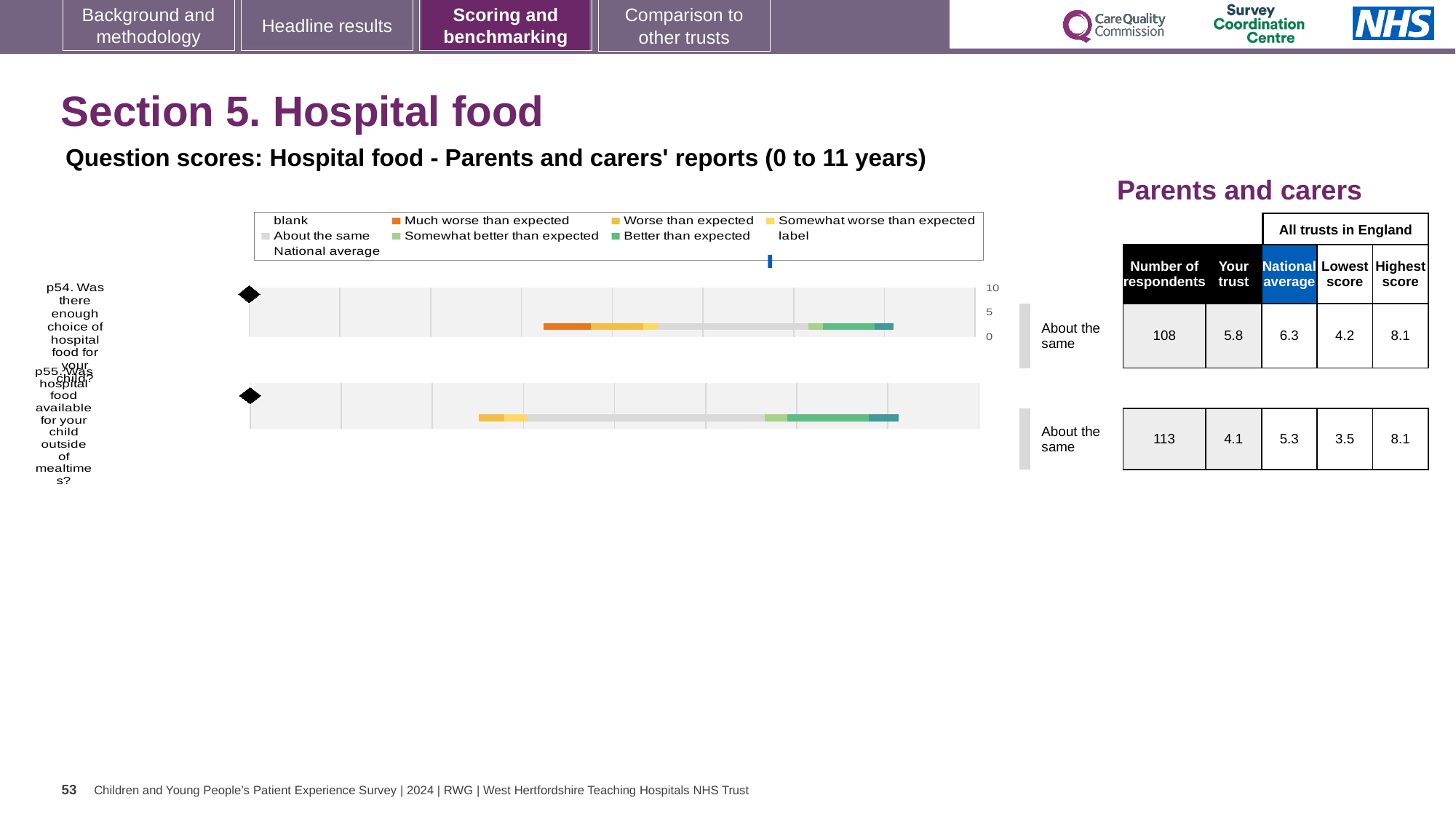
According to the table beside the chart, how many respondents answered p55? 113 Which question has the higher 'Your trust' score in the table, p54 or p55? p54 What is the difference between the national average and the 'Your trust' score for p55 in the table? 1.2 What benchmark category is shown next to both bars in the chart? About the same According to the table beside the chart, what is the 'Your trust' score for p55 (food available outside of mealtimes)? 4.1 Which colour in the legend represents 'Much worse than expected'? orange What kind of chart is shown on the slide? bar chart According to the table beside the chart, what is the national average for p54? 6.3 According to the table beside the chart, what is the 'Your trust' score for p54 (enough choice of hospital food)? 5.8 What is the highest value shown on the chart's axis? 10 How many questions (bars) are plotted in the chart? 2 What is the highest score across all trusts in England for p54 in the table? 8.1